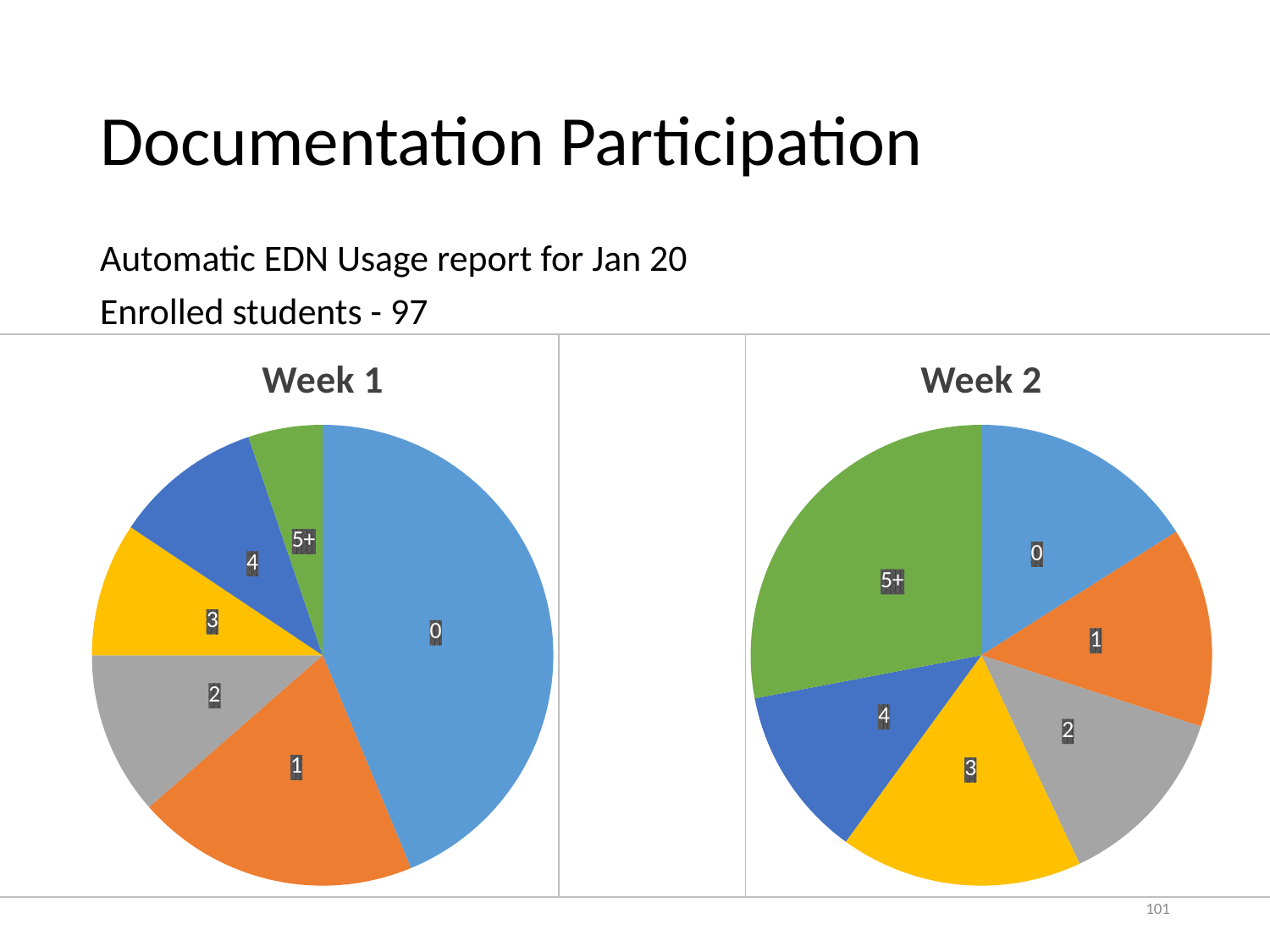
In the Week 1 chart, which slice is the smallest? 5+ In the Week 2 chart, what colour is the slice labelled 5+? green In the Week 1 chart, which slice is the largest? 0 In the Week 2 chart, how many slices does the pie have? 6 In the Week 1 chart, how many slices does the pie have? 6 In the Week 1 chart, which slice is larger, 3 or 5+? 3 In the Week 2 chart, which slice is the largest? 5+ In the Week 2 chart, which slice is larger, 5+ or 0? 5+ What kind of chart is the Week 2 chart? pie chart What kind of chart is the Week 1 chart? pie chart In the Week 1 chart, which slice is larger, 0 or 1? 0 What is the title of the chart on the left side of the slide? Week 1